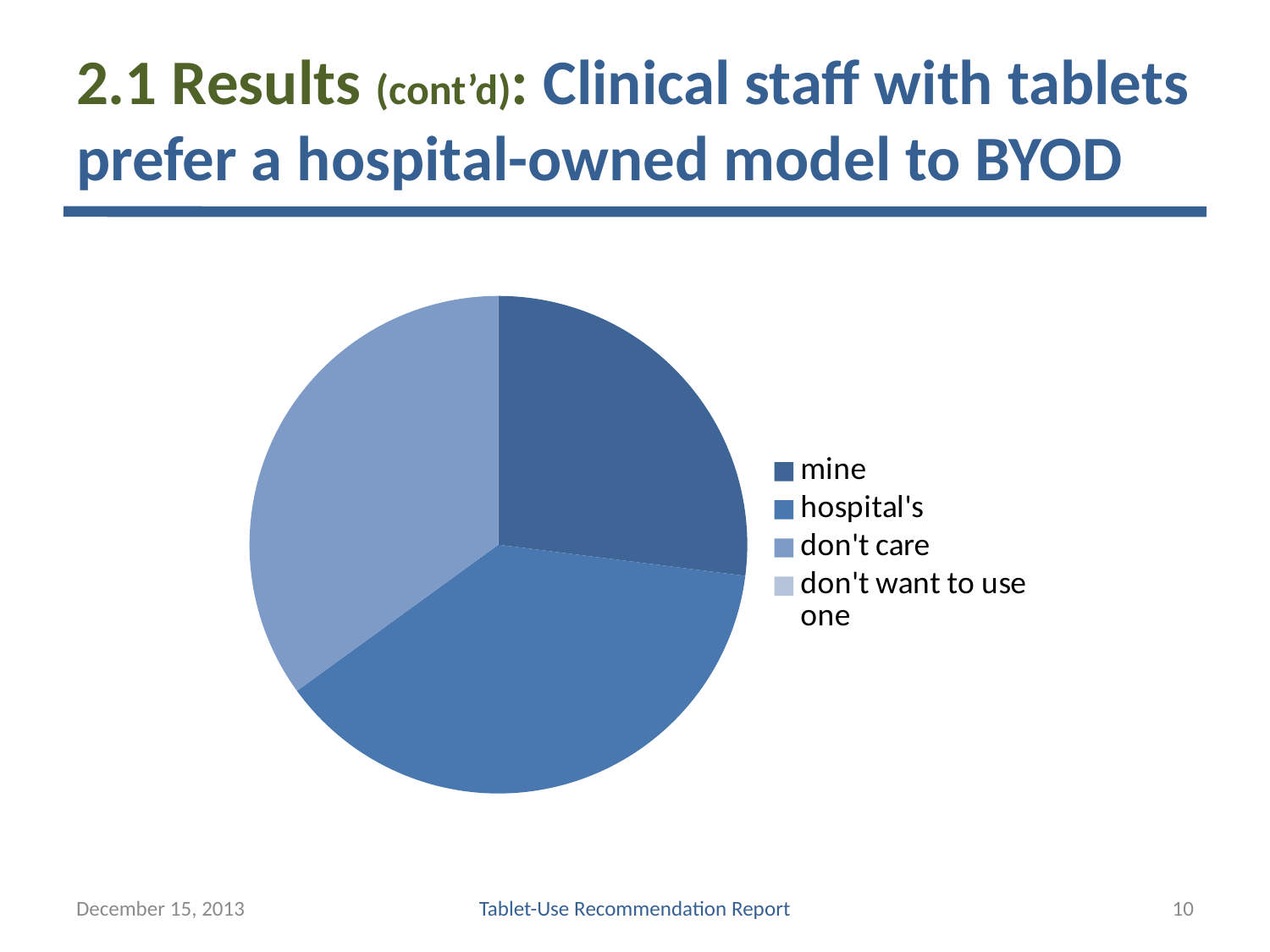
What kind of chart is shown on the slide? pie chart Which of the two slices is larger, "mine" or "hospital's"? hospital's How many entries does the legend of the pie chart list? 4 Which of the two slices is larger, "mine" or "don't care"? don't care Which legend entry is listed last in the pie chart's legend? don't want to use one Which legend entry is listed first in the pie chart's legend? mine